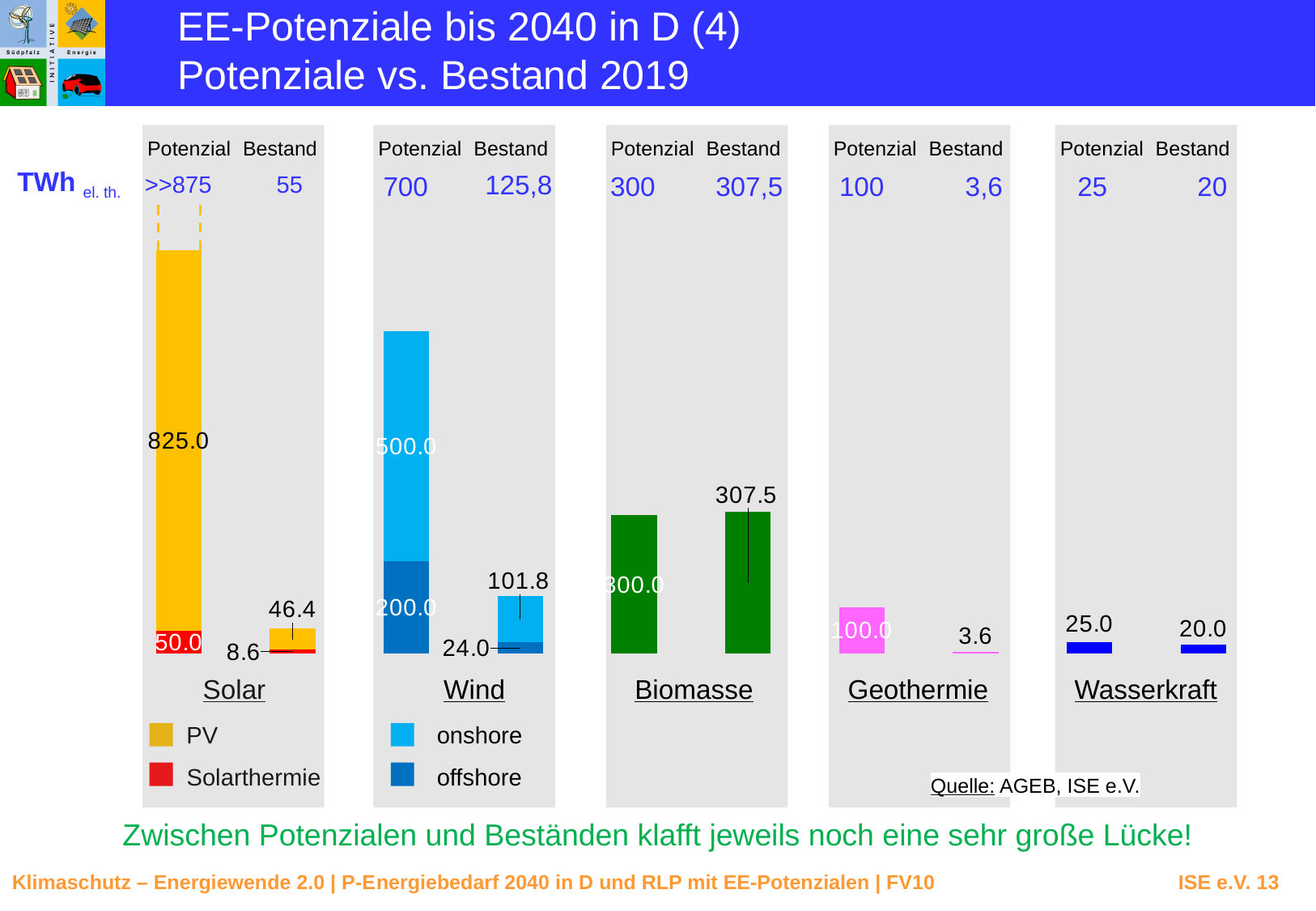
In the Geothermie chart, what is the Bestand value shown above the bar? 3.6 In the Biomasse chart, what is the Bestand value printed in the header row? 307,5 In the Solar chart, what is the PV value of the Potenzial bar? 825.0 In the Biomasse chart, which bar is taller, Potenzial or Bestand? Bestand In the Solar chart, how many series does the legend list? 2 In the Wasserkraft chart, what is the difference between the Potenzial bar (25.0) and the Bestand bar (20.0)? 5.0 In the Wind chart, what is the offshore value of the Bestand bar? 24.0 What type of chart is used in the Wind panel? Bar chart In the Solar chart, what is the total of the Bestand stacked bar (46.4 PV plus 8.6 Solarthermie)? 55.0 In the Wind chart, what is the difference between the onshore Potenzial (500.0) and the offshore Potenzial (200.0)? 300.0 How many energy source panels (charts) are shown on the slide? 5 In the Wind chart, what is the total of the Potenzial stacked bar (500.0 onshore plus 200.0 offshore)? 700.0